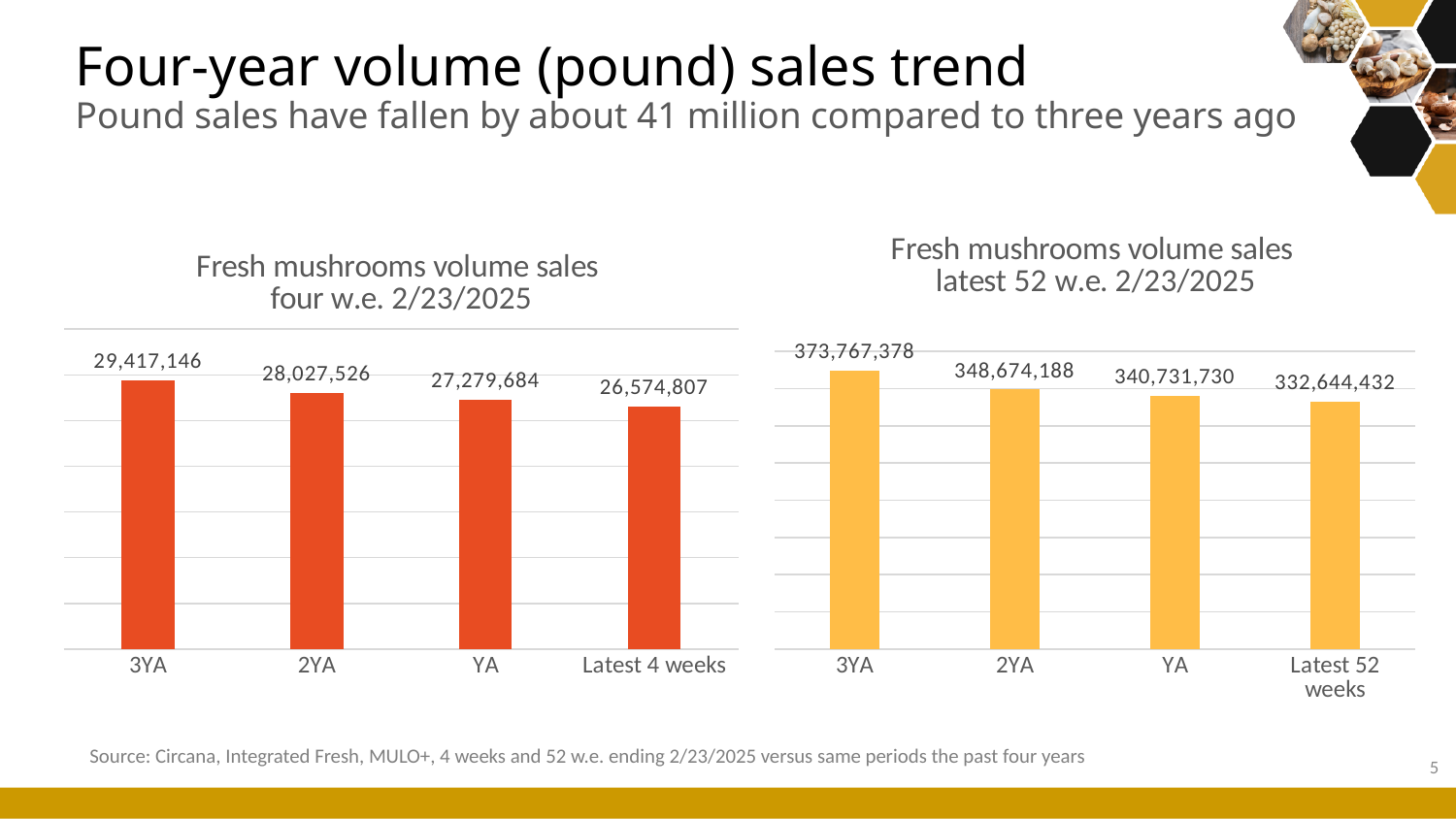
In the 'Fresh mushrooms volume sales latest 52 w.e. 2/23/2025' chart, what is the value for Latest 52 weeks? 332,644,432 What kind of chart is the 'Fresh mushrooms volume sales latest 52 w.e. 2/23/2025' chart? Bar chart In the 'Fresh mushrooms volume sales latest 52 w.e. 2/23/2025' chart, which is larger, the value for 2YA or the value for YA? 2YA How many categories are shown in the 'Fresh mushrooms volume sales four w.e. 2/23/2025' chart? 4 In the 'Fresh mushrooms volume sales four w.e. 2/23/2025' chart, what is the difference between the 3YA value and the Latest 4 weeks value? 2,842,339 In the 'Fresh mushrooms volume sales latest 52 w.e. 2/23/2025' chart, what is the difference between the 3YA value and the Latest 52 weeks value? 41,122,946 In the 'Fresh mushrooms volume sales four w.e. 2/23/2025' chart, what is the value for 3YA? 29,417,146 In the 'Fresh mushrooms volume sales latest 52 w.e. 2/23/2025' chart, which category has the lowest value? Latest 52 weeks In the 'Fresh mushrooms volume sales four w.e. 2/23/2025' chart, what is the value for Latest 4 weeks? 26,574,807 In the 'Fresh mushrooms volume sales four w.e. 2/23/2025' chart, which category has the highest value? 3YA In the 'Fresh mushrooms volume sales four w.e. 2/23/2025' chart, do the values rise or fall from 3YA to Latest 4 weeks? Fall In the 'Fresh mushrooms volume sales latest 52 w.e. 2/23/2025' chart, what is the value for 2YA? 348,674,188